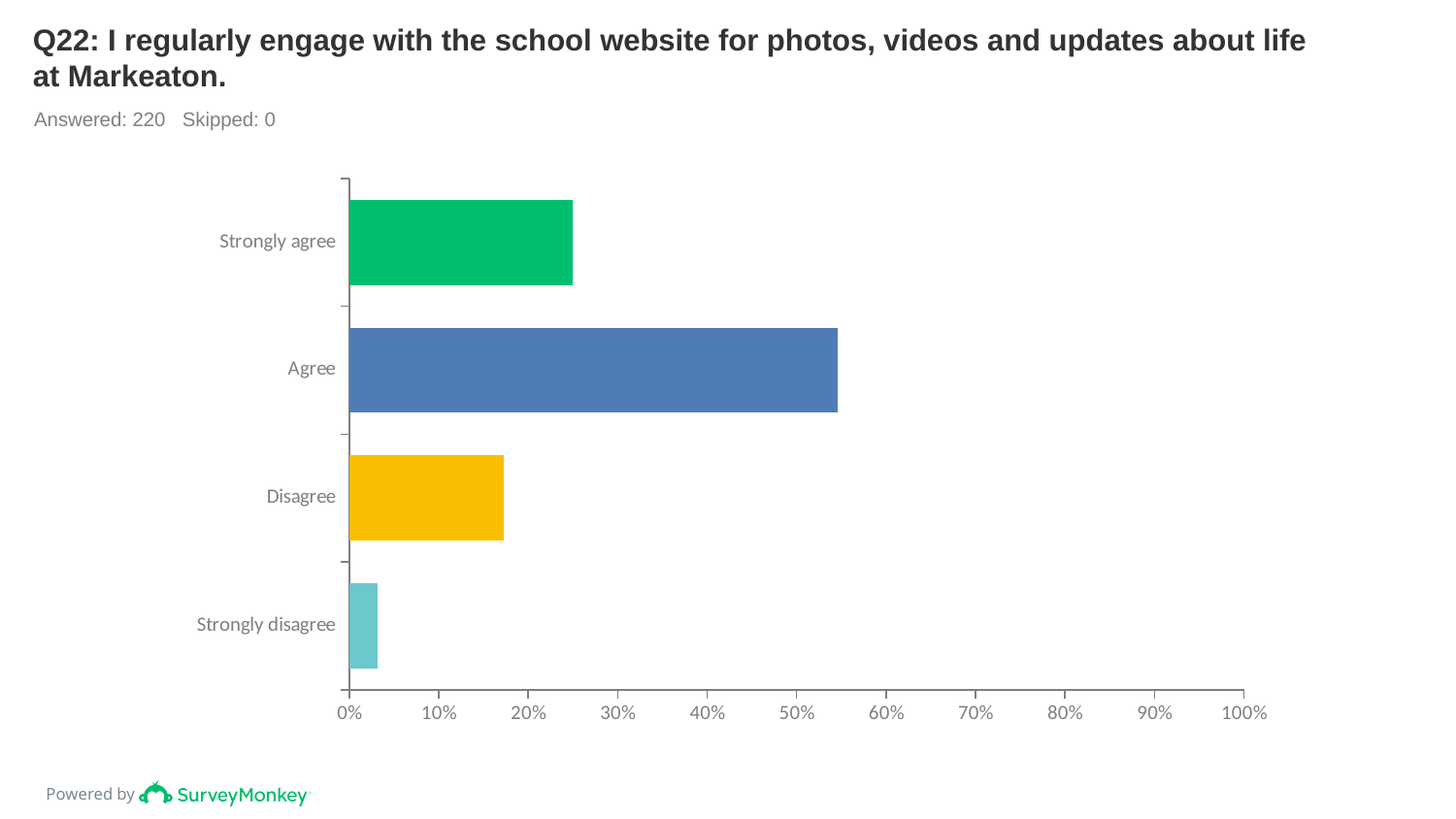
How many respondents answered this question according to the slide? 220 Is the value for Strongly agree greater or less than 30%? less Which response category has the lowest value? Strongly disagree Is the value for Agree greater or less than 50%? greater Is the value for Strongly disagree greater or less than 10%? less How many response categories are shown in the chart? 4 Which is larger, the value for Agree or the value for Strongly agree? Agree What kind of chart is shown on the slide? bar chart Which is larger, the value for Strongly agree or the value for Disagree? Strongly agree Which response category has the highest value? Agree What colour is the bar for Disagree? yellow